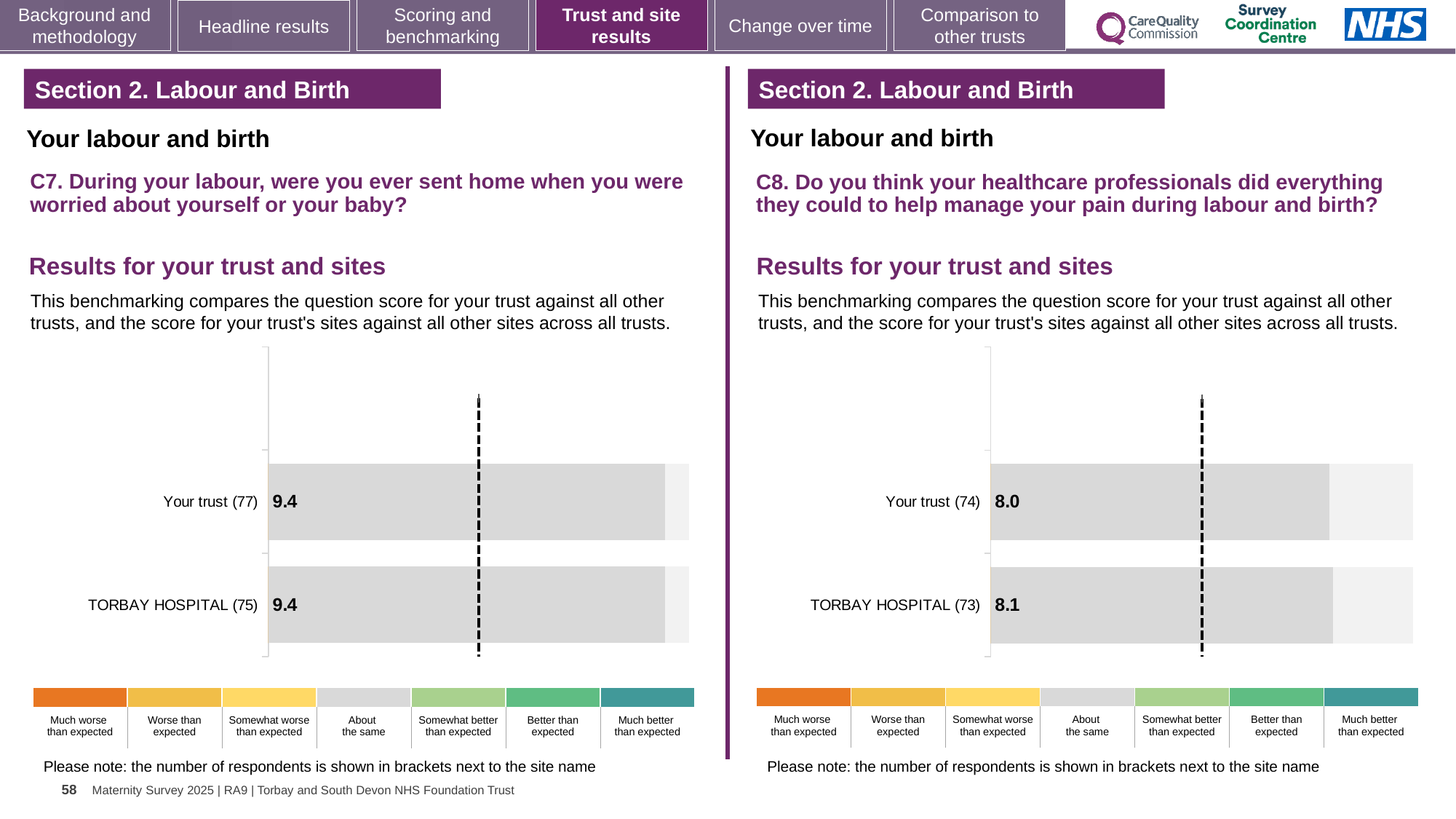
In the C8 chart on the right, what is the difference between the TORBAY HOSPITAL score and the Your trust score? 0.1 In the C8 chart on the right, what is the score for TORBAY HOSPITAL? 8.1 In the C8 chart on the right, what is the score for Your trust? 8.0 In the C7 chart on the left, how many respondents are shown in brackets for Your trust? 77 In the C8 chart on the right, which has the higher score, Your trust or TORBAY HOSPITAL? TORBAY HOSPITAL In the C7 chart on the left, what is the score for Your trust? 9.4 What type of chart is used for the C8 results on the right? Bar chart In the C8 chart on the right, how many respondents are shown in brackets for TORBAY HOSPITAL? 73 In the C7 chart on the left, what is the difference between the Your trust score and the TORBAY HOSPITAL score? 0 How many bars are plotted in the C7 chart on the left? 2 In the C7 chart on the left, what is the score for TORBAY HOSPITAL? 9.4